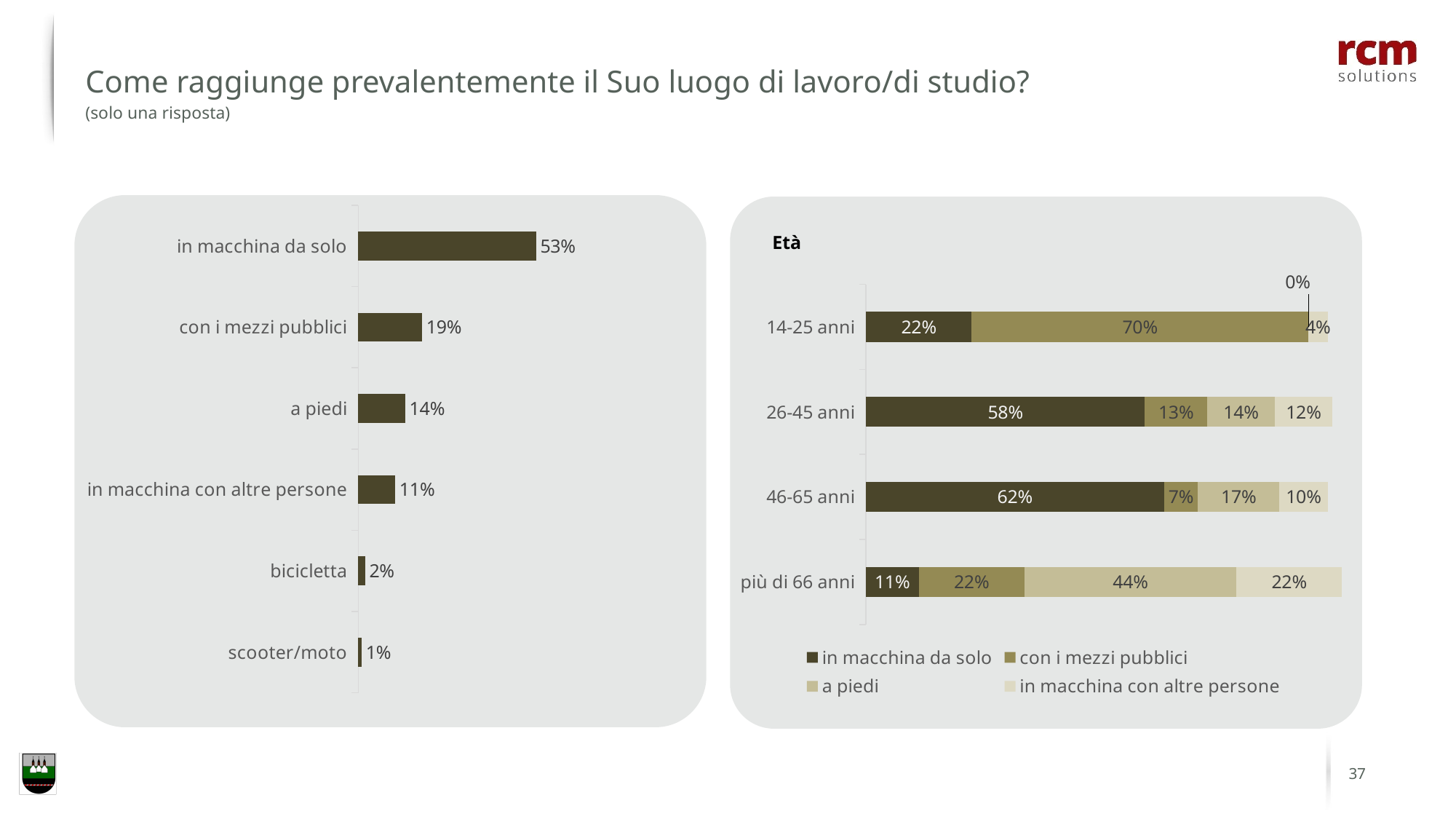
In the left chart, what percentage of respondents reach their workplace or place of study 'in macchina da solo'? 53% In the 'Età' chart on the right, what is the difference between 'a piedi' and 'con i mezzi pubblici' in the 46-65 anni group? 10% In the 'Età' chart on the right, how many series does the legend list? 4 In the 'Età' chart on the right, is the value for 'in macchina da solo' larger in the 26-45 anni group or in the 14-25 anni group? 26-45 anni In the left chart, which category has the lowest value? scooter/moto In the left chart, what is the difference between 'con i mezzi pubblici' and 'a piedi'? 5% In the 'Età' chart on the right, what is the value for 'a piedi' in the 'più di 66 anni' group? 44% In the 'Età' chart on the right, which age group has the highest value for 'in macchina da solo'? 46-65 anni In the left chart, how many categories are shown? 6 What type of chart is the left chart? bar chart In the 'Età' chart on the right, what is the value for 'a piedi' in the 14-25 anni group? 0% In the 'Età' chart on the right, what is the value for 'con i mezzi pubblici' in the 14-25 anni group? 70%